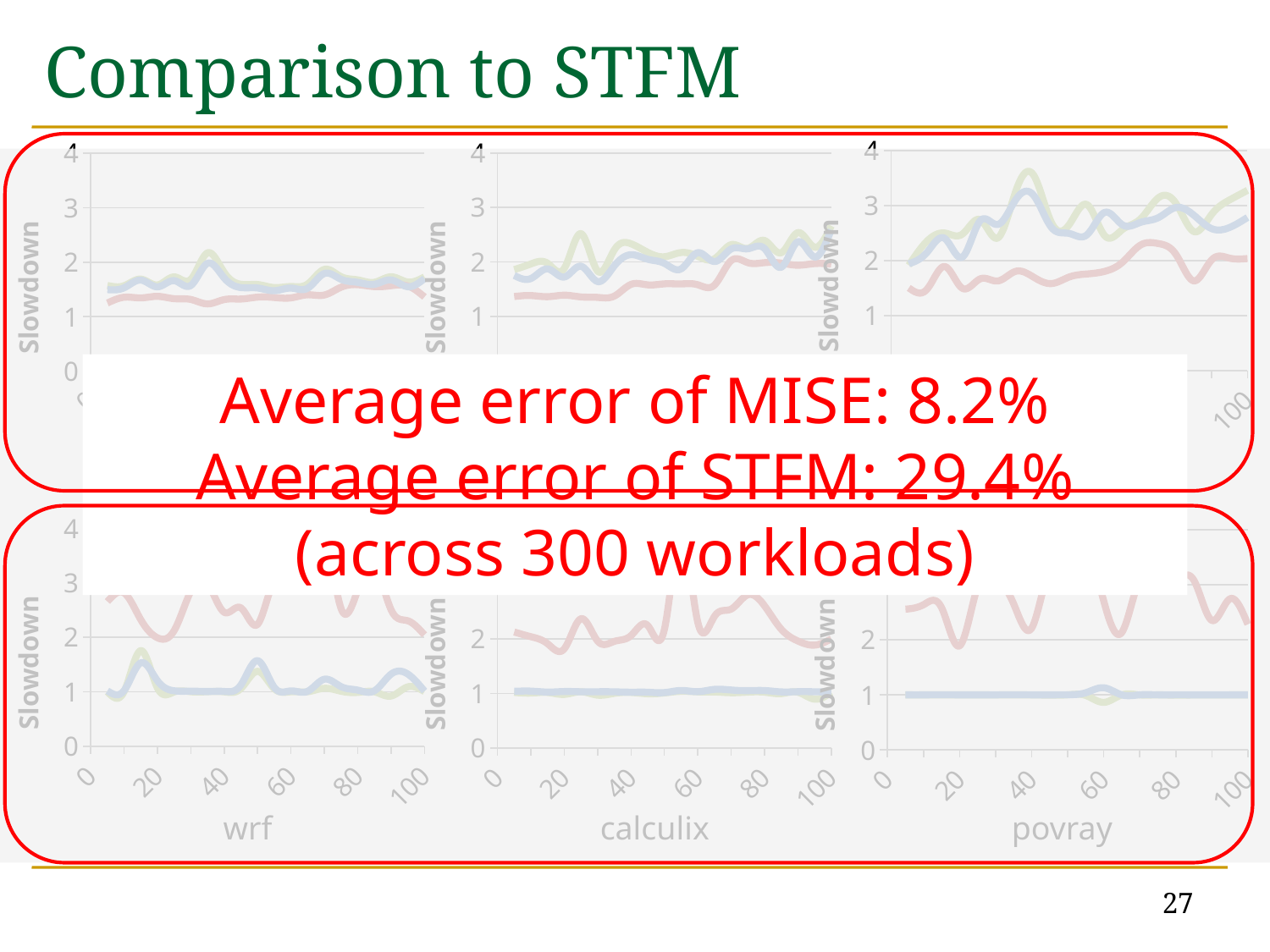
In the top-left chart, is the peak of the green line greater or less than 3? less In the top-right chart, does the blue line generally rise or fall from x=0 to x=40? rise In the bottom-middle chart (calculix), which line is higher, the red line or the blue line? red line What is the x-axis title of the bottom-left chart? wrf In the top-right chart, is the peak of the green line greater or less than 3? greater What is the highest tick value shown on the y axis of the charts? 4 How many charts are shown on the slide? 6 What is the y-axis label on the charts? Slowdown What kind of charts are shown on the slide? line charts In the bottom-middle chart (calculix), is the blue line greater or less than 2 across the x axis? less